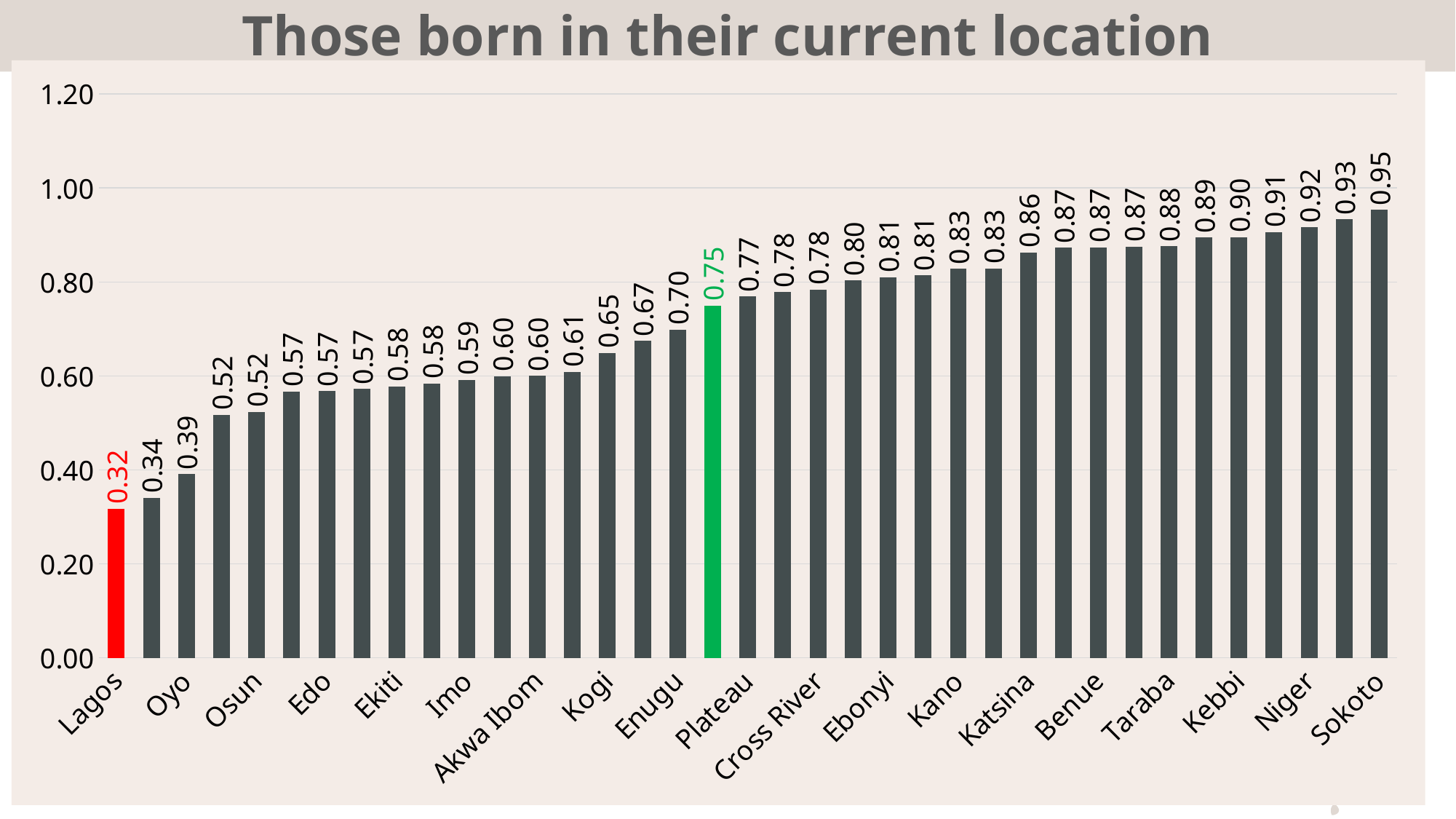
Is the value for Sokoto greater or less than 0.80? greater Do the values rise or fall from left to right along the x axis? Rise What is the difference between the values for Sokoto and Lagos? 0.63 What is the value of the bar for Sokoto? 0.95 Is the value for Lagos greater or less than 0.40? less What is the title of the chart? Those born in their current location Which is larger, the value for Lagos or the value for Sokoto? Sokoto Which location has the highest value? Sokoto What is the value for Lagos? 0.32 Which location has the lowest value? Lagos What value is labelled on the green bar? 0.75 What kind of chart is shown on the slide? Bar chart